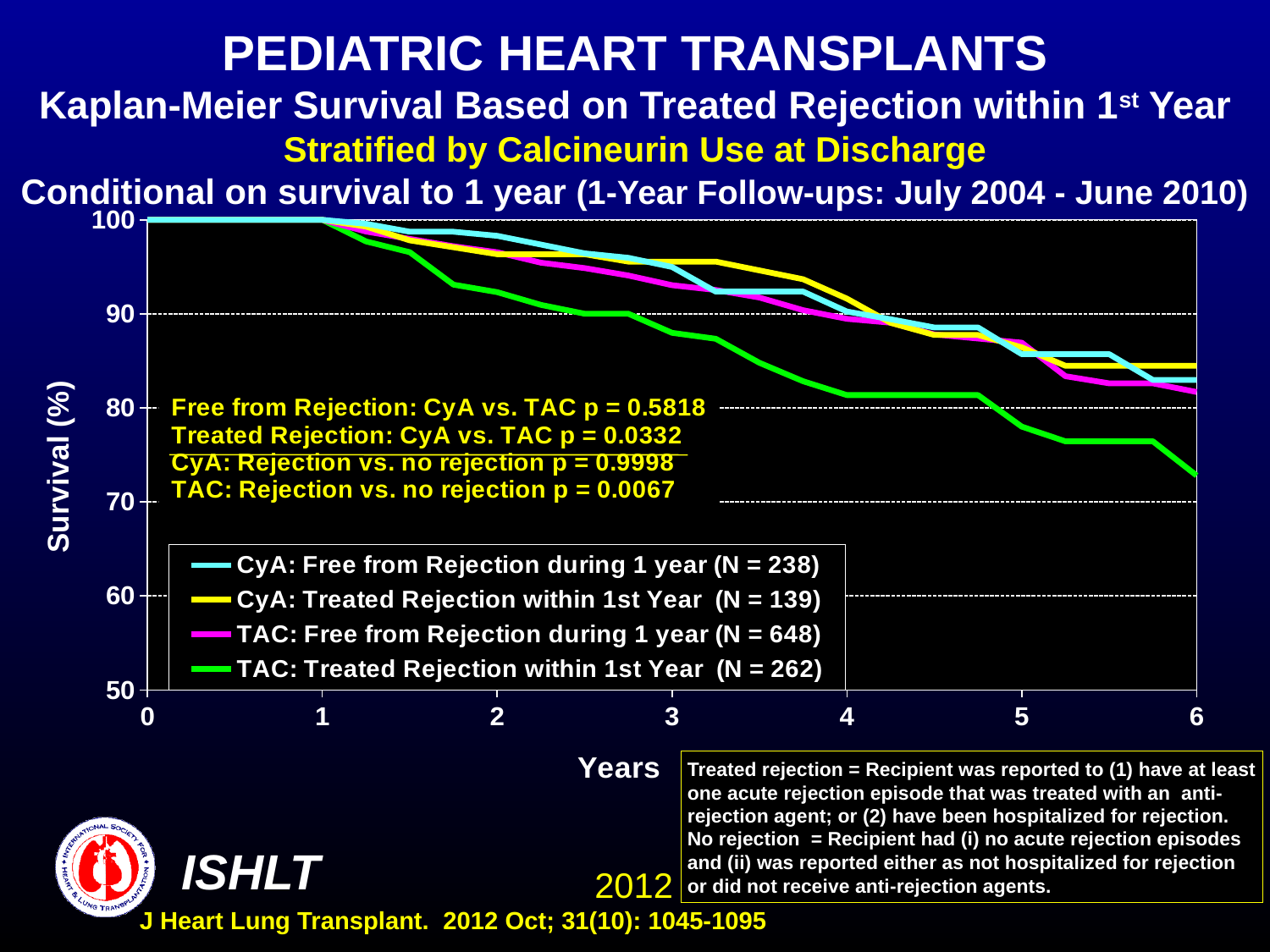
Which series has the lowest survival at 6 years? TAC: Treated Rejection within 1st Year Is the survival for 'TAC: Treated Rejection within 1st Year' at 6 years greater or less than 80? less Is the survival for 'CyA: Treated Rejection within 1st Year' at 3 years greater or less than 90? greater What p-value is given for 'Free from Rejection: CyA vs. TAC'? p = 0.5818 What is the N for the series 'TAC: Free from Rejection during 1 year'? N = 648 Do the survival curves rise or fall as years increase? Fall What p-value is given for 'TAC: Rejection vs. no rejection'? p = 0.0067 What is the N for the series 'CyA: Free from Rejection during 1 year'? N = 238 What is the label of the y-axis? Survival (%) How many series does the legend list? 4 What is the N for the series 'TAC: Treated Rejection within 1st Year'? N = 262 What kind of chart is shown on the slide? Line chart